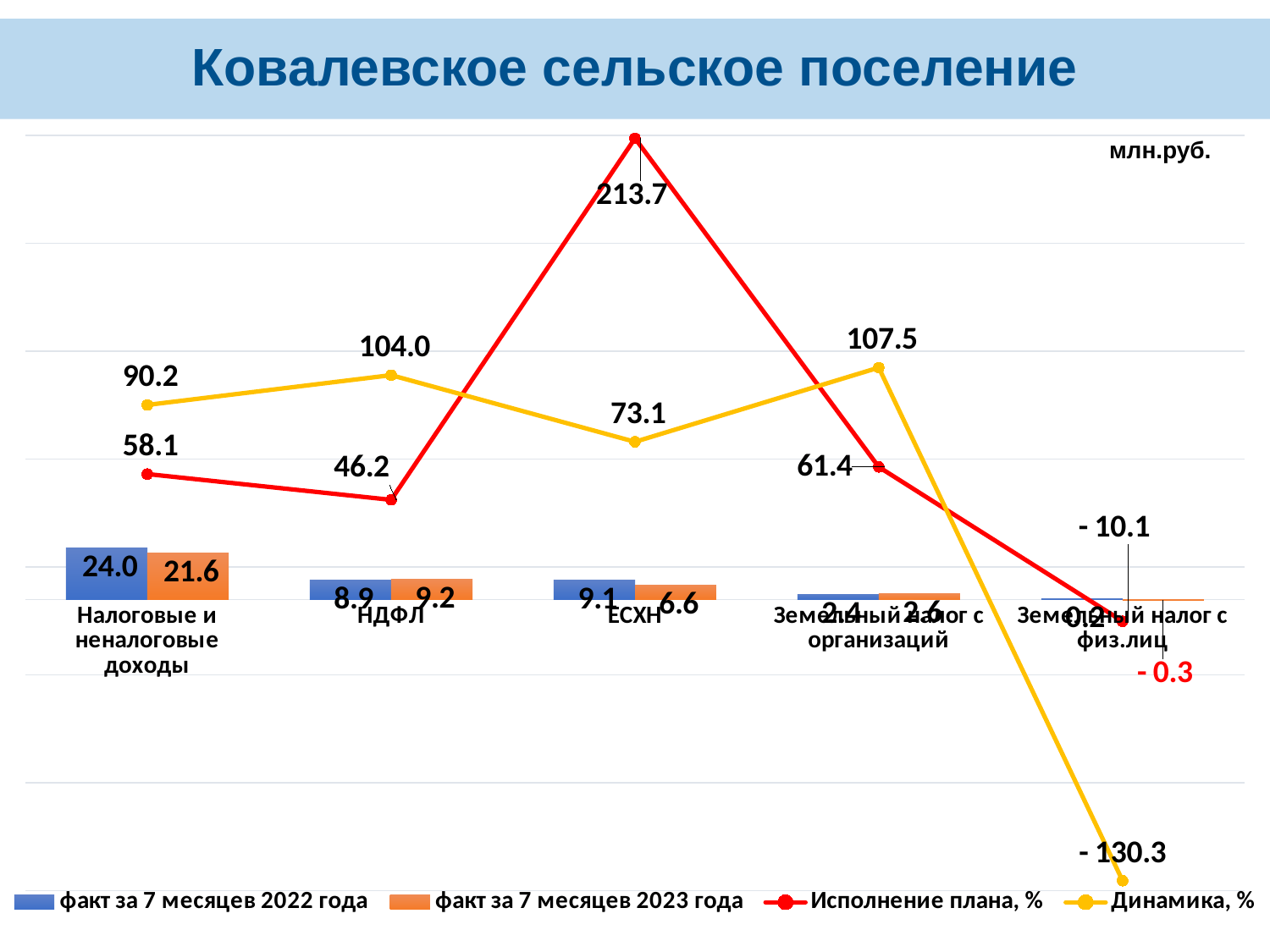
What is the value of 'факт за 7 месяцев 2023 года' for 'Налоговые и неналоговые доходы'? 21.6 What is the 'Динамика, %' value for 'Земельный налог с физ.лиц'? - 130.3 What is the difference between the 'факт за 7 месяцев 2022 года' and 'факт за 7 месяцев 2023 года' values for 'ЕСХН'? 2.5 What unit is shown in the top right corner of the chart? млн.руб. For 'НДФЛ', which is larger: 'факт за 7 месяцев 2022 года' or 'факт за 7 месяцев 2023 года'? факт за 7 месяцев 2023 года How many series does the legend list? 4 What is the value of 'факт за 7 месяцев 2022 года' for 'Налоговые и неналоговые доходы'? 24.0 What is the 'Исполнение плана, %' value for 'ЕСХН'? 213.7 What is the 'Исполнение плана, %' value for 'Земельный налог с организаций'? 61.4 Which category has the lowest 'Динамика, %' value? Земельный налог с физ.лиц What is the 'Динамика, %' value for 'НДФЛ'? 104.0 Which category has the highest 'Исполнение плана, %' value? ЕСХН